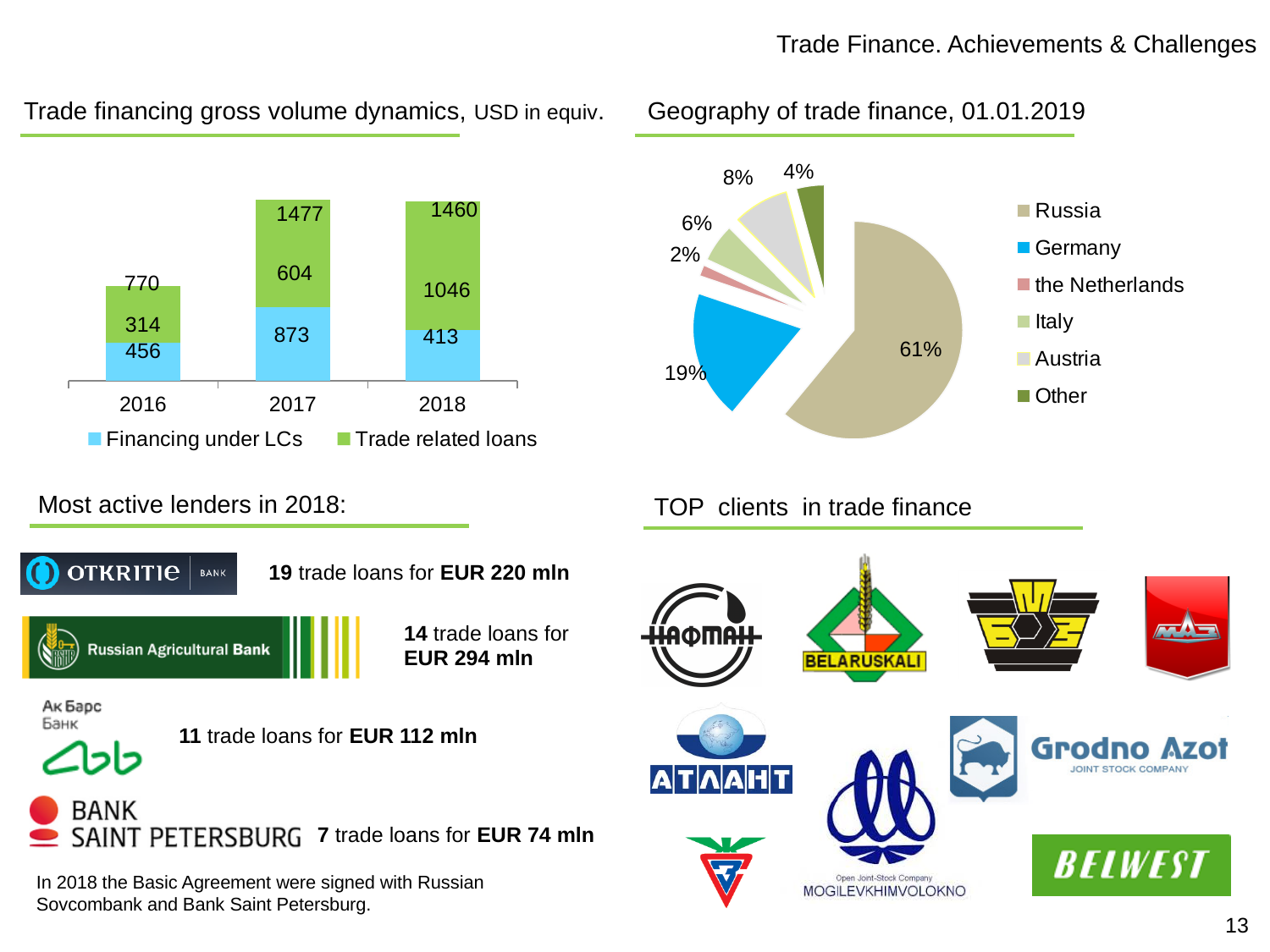
What kind of chart is 'Trade financing gross volume dynamics'? Stacked bar chart In the 'Geography of trade finance, 01.01.2019' pie chart, what share does Russia have? 61% How many series does the legend of the 'Trade financing gross volume dynamics' chart list? 2 In the 'Trade financing gross volume dynamics' chart, what is the total of the stacked bar for 2016? 770 How many categories does the legend of the 'Geography of trade finance, 01.01.2019' pie chart list? 6 In the 'Trade financing gross volume dynamics' chart, what is the value for Financing under LCs in 2017? 873 In the 'Trade financing gross volume dynamics' chart, which is larger in 2018: Financing under LCs or Trade related loans? Trade related loans In the 'Trade financing gross volume dynamics' chart, what is the difference between Trade related loans in 2018 and in 2017? 442 In the 'Trade financing gross volume dynamics' chart, which year has the highest total trade financing volume? 2017 In the 'Geography of trade finance, 01.01.2019' pie chart, which country has the smallest share? the Netherlands In the 'Geography of trade finance, 01.01.2019' pie chart, what is the difference between the shares of Germany and Austria? 11% In the 'Trade financing gross volume dynamics' chart, what is the value for Trade related loans in 2018? 1046